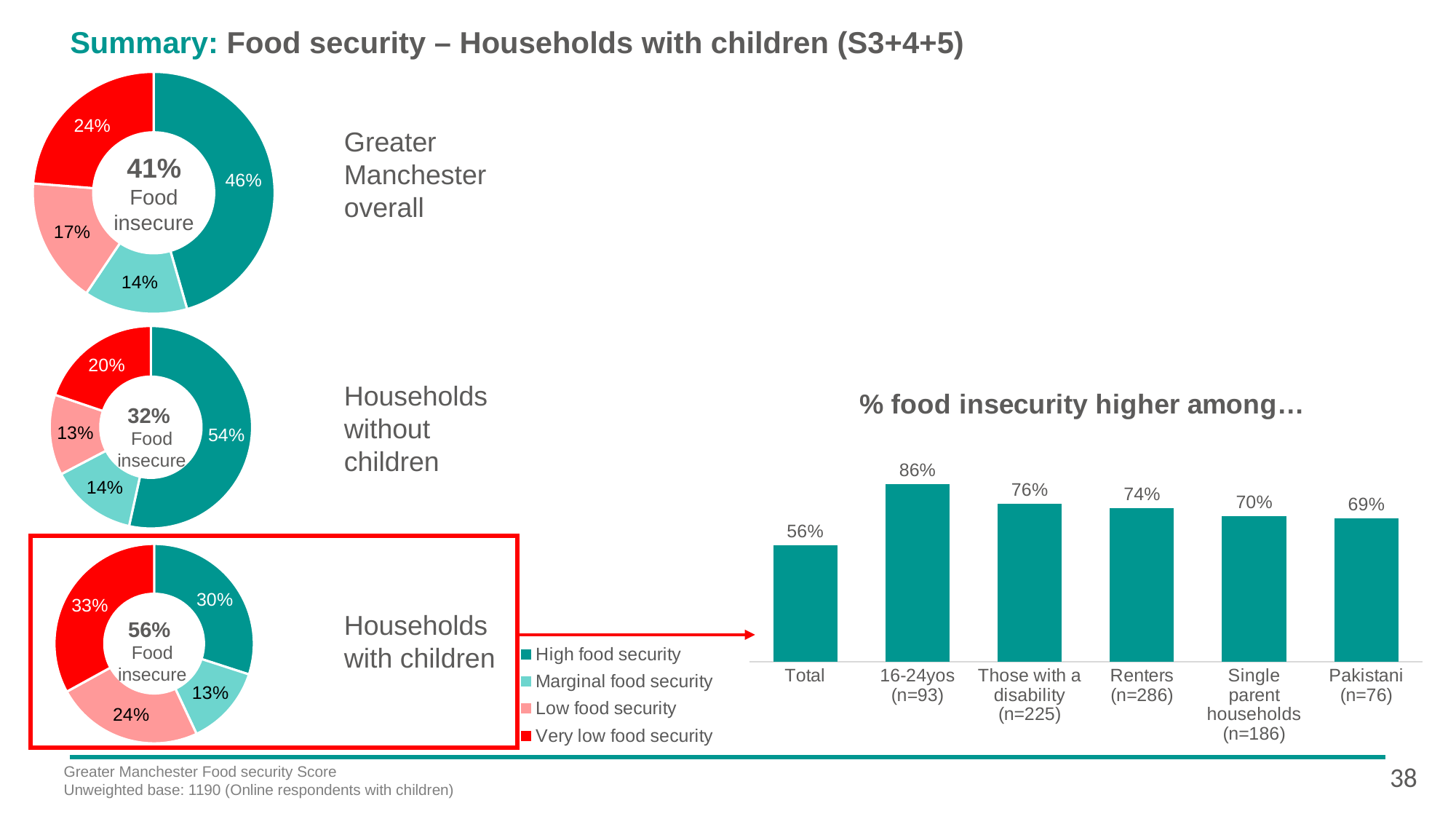
In the '% food insecurity higher among…' bar chart, which category has the highest value? 16-24yos (n=93) How many series does the legend for the donut charts list? 4 In the 'Households without children' donut chart, what is the Food insecure percentage shown in the centre? 32% What is the title of the bar chart on the right of the slide? % food insecurity higher among… In the '% food insecurity higher among…' bar chart, how many categories are shown? 6 In the '% food insecurity higher among…' bar chart, what is the value for Renters (n=286)? 74% In the '% food insecurity higher among…' bar chart, which category has the lowest value? Total In the '% food insecurity higher among…' bar chart, what is the difference between the value for 16-24yos (n=93) and the value for Total? 30% In the 'Households with children' donut chart, what share is Very low food security (red)? 33% Which is larger: the Low food security share in the 'Households with children' donut or in the 'Households without children' donut? Households with children In the 'Greater Manchester overall' donut chart, what share is High food security (dark teal)? 46% What kind of chart is the '% food insecurity higher among…' chart? Bar chart